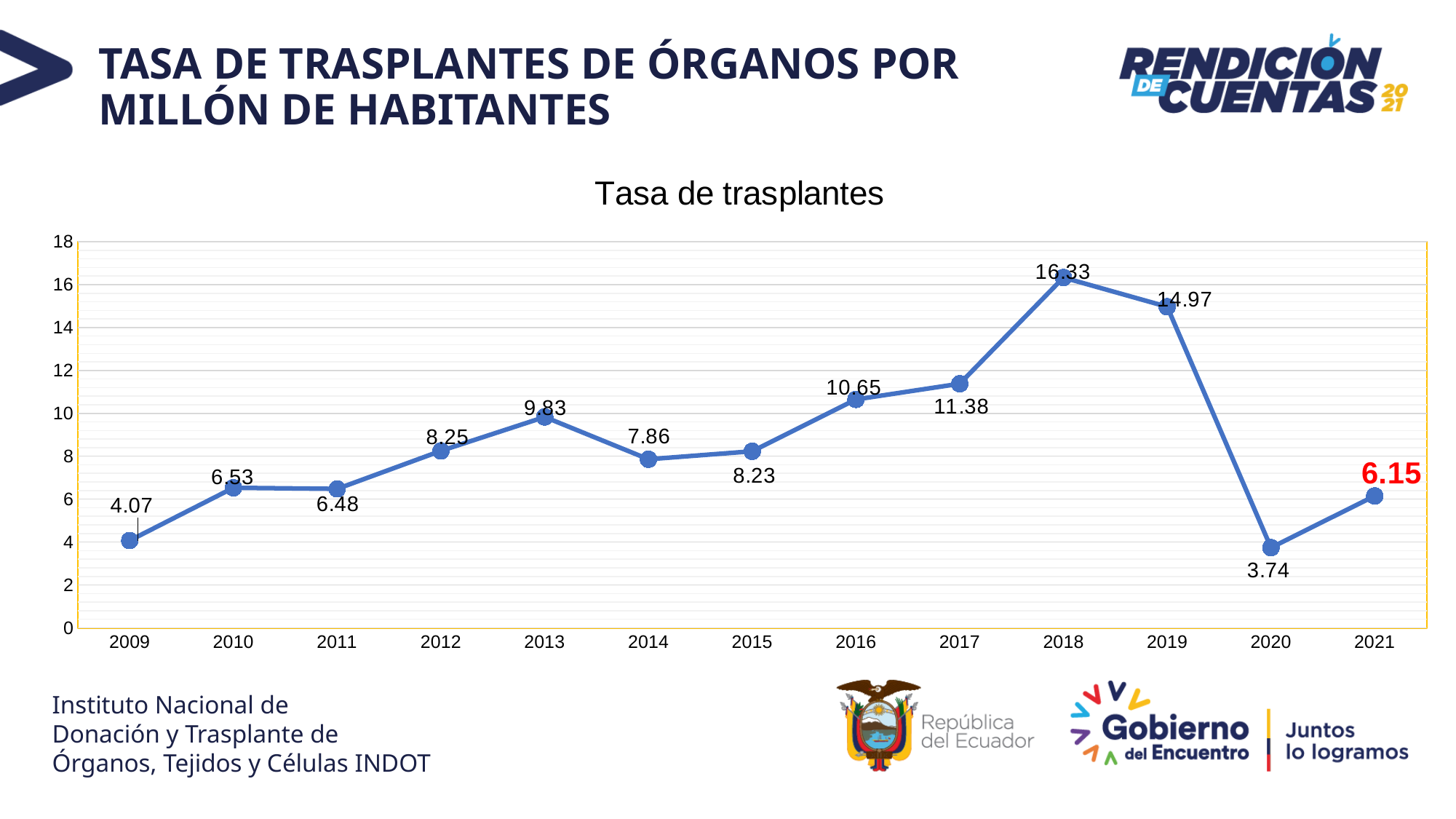
What is the transplant rate shown for 2021? 6.15 Did the transplant rate rise or fall from 2019 to 2020? Fall What kind of chart is shown on the slide? Line chart What is the transplant rate shown for 2018? 16.33 What is the difference between the transplant rate in 2021 and in 2020? 2.41 Which year has the highest transplant rate? 2018 What is the transplant rate shown for 2009? 4.07 What is the title of the chart? Tasa de trasplantes How many years are plotted on the chart? 13 What is the difference between the transplant rate in 2018 and in 2019? 1.36 Which year has a higher transplant rate, 2013 or 2014? 2013 Which year has the lowest transplant rate? 2020